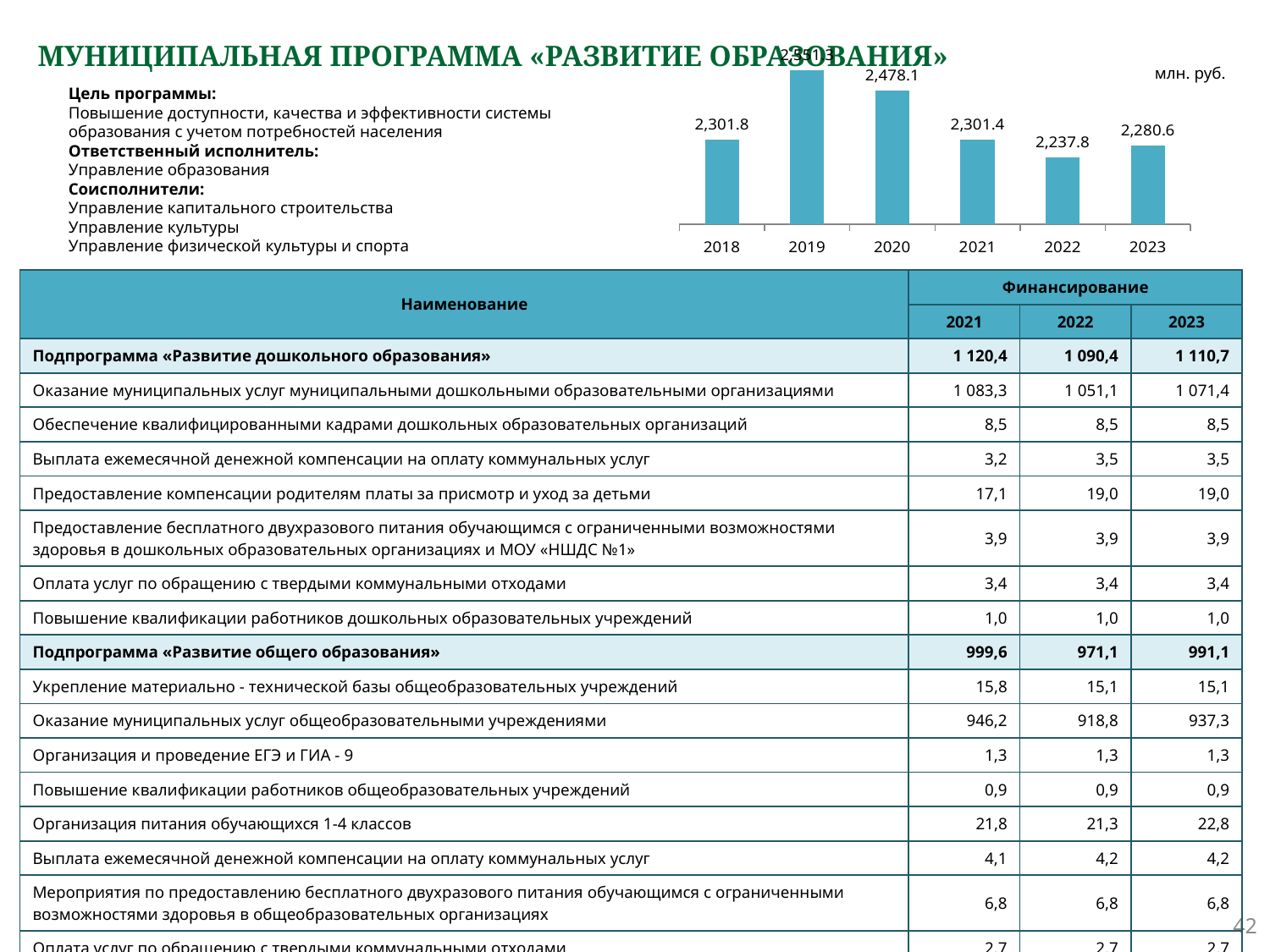
What is the value shown for 2022 on the bar chart? 2,237.8 What is the value shown for 2018 on the bar chart? 2,301.8 What type of chart is shown on the slide? Bar chart How many years are shown on the bar chart? 6 What is the value shown for 2023 on the bar chart? 2,280.6 Which is larger on the bar chart, the value for 2022 or the value for 2023? 2023 What is the difference between the values for 2020 and 2021 on the bar chart? 176.7 Which year has the tallest bar on the chart? 2019 What is the difference between the values for 2021 and 2022 on the bar chart? 63.6 Do the values on the bar chart rise or fall from 2020 to 2022? Fall What is the value shown for 2020 on the bar chart? 2,478.1 Which year has the lowest bar on the chart? 2022